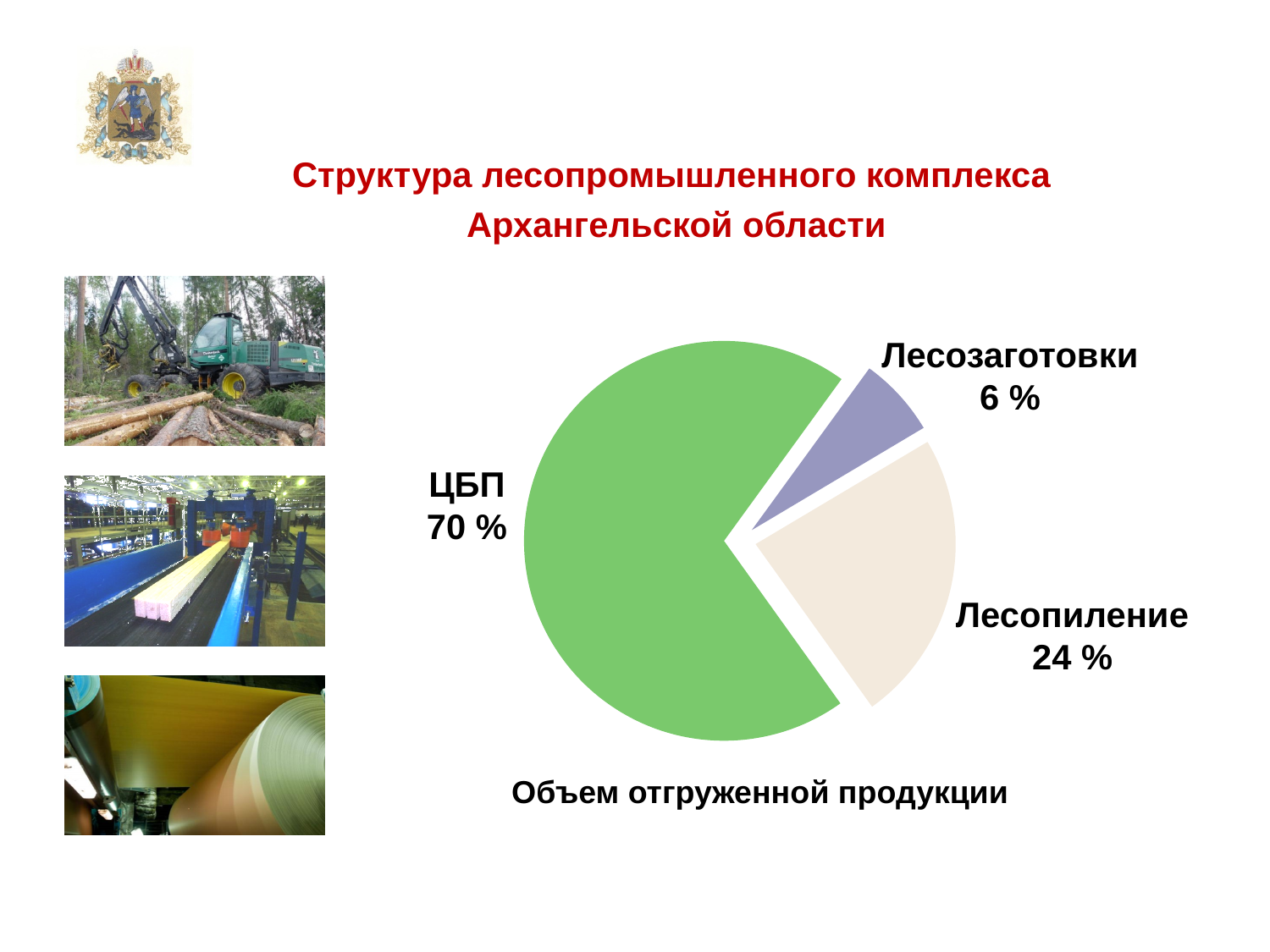
Which slice of the pie is the smallest? Лесозаготовки What is the caption printed below the pie chart? Объем отгруженной продукции How many slices does the pie chart have? 3 What colour is the ЦБП slice of the pie? green What share of the pie does Лесопиление have? 24 % What share of the pie does Лесозаготовки have? 6 % Which slice of the pie is the largest? ЦБП What kind of chart is shown on the slide? pie chart What is the difference in percentage points between ЦБП and Лесопиление? 46 What is the difference in percentage points between Лесопиление and Лесозаготовки? 18 Which is larger, Лесопиление or Лесозаготовки? Лесопиление What share of the pie does ЦБП have? 70 %